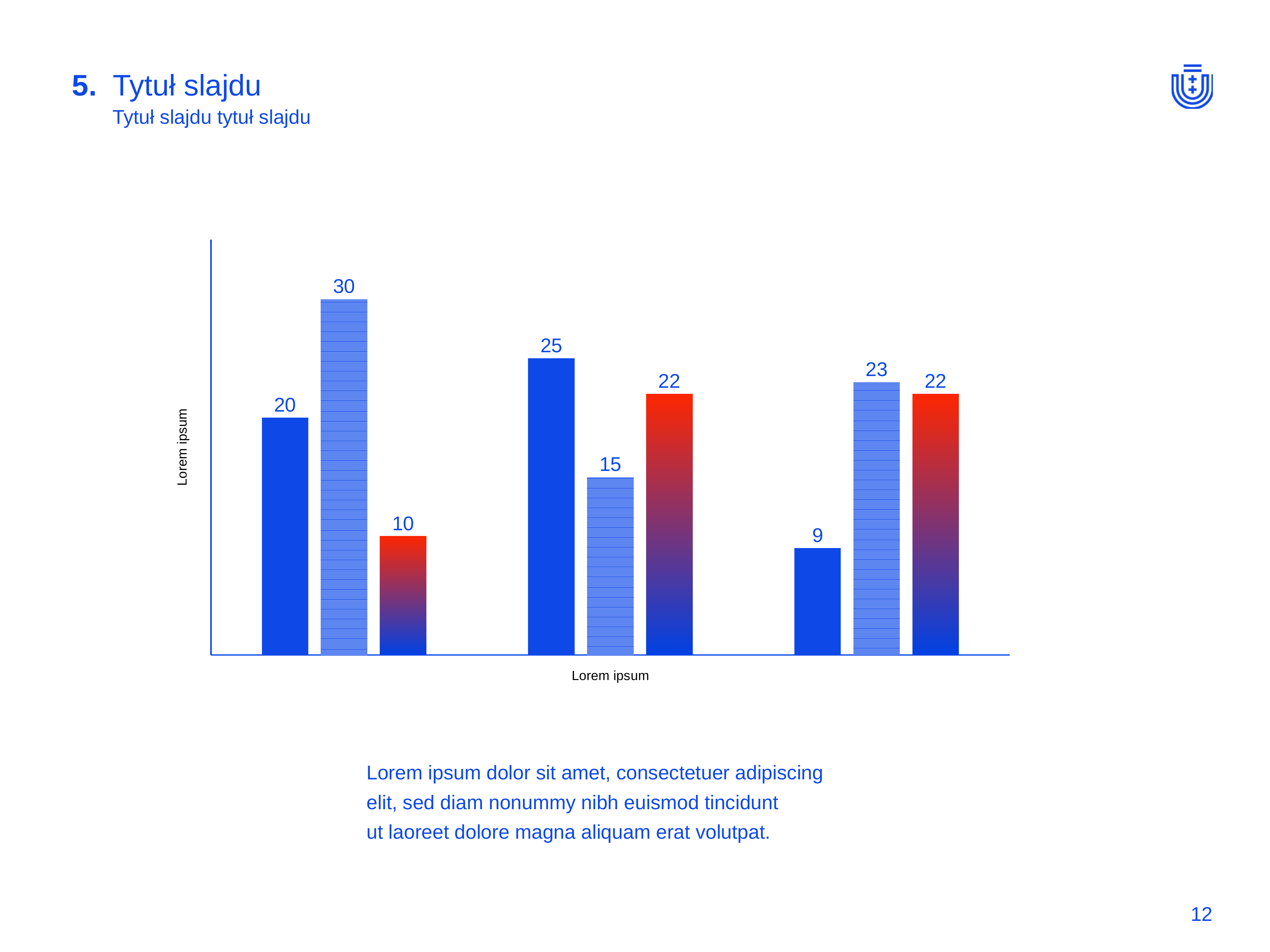
What kind of chart is shown on the slide? bar chart How many bars are plotted in the chart? 9 What is the lowest value shown in the chart? 9 What is the difference between the striped bar and the gradient bar in the first (leftmost) group? 20 What is the title of the horizontal axis of the chart? Lorem ipsum What is the value of the red-to-blue gradient bar in the third (rightmost) group? 22 What is the highest value shown in the chart? 30 Which is larger: the solid blue bar in the second group or the solid blue bar in the third group? the solid blue bar in the second group What is the value of the solid blue bar in the second (middle) group? 25 How many bars in the chart are labeled 22? 2 How many groups of bars does the chart contain? 3 What is the value of the striped bar in the first (leftmost) group? 30